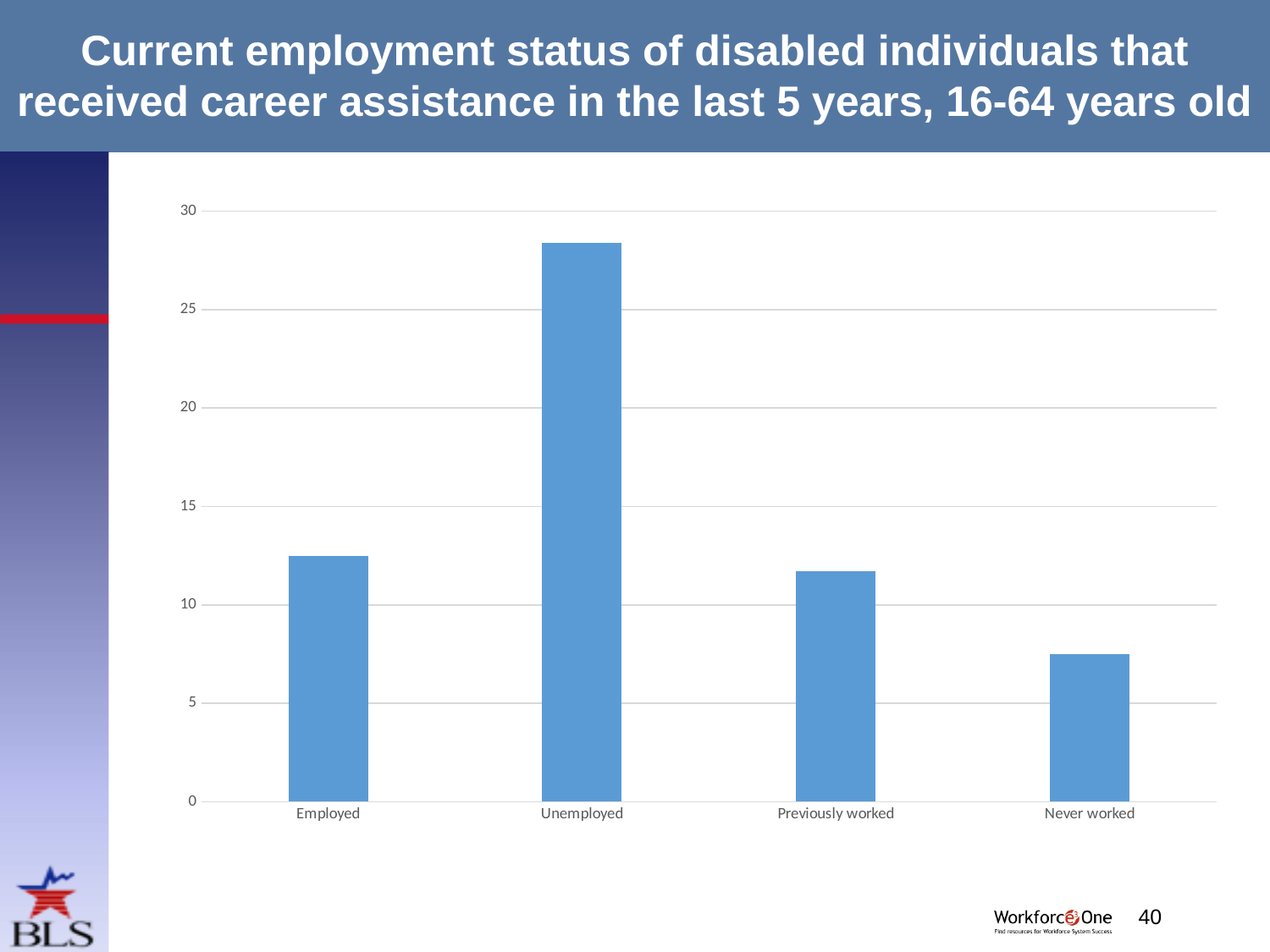
Is the value for Employed greater or less than 15? less Is the value for Unemployed greater or less than 25? greater Which category has the highest bar in the chart? Unemployed Which is larger, the value for Unemployed or the value for Previously worked? Unemployed How many categories are shown on the x axis of the chart? 4 Which category has the lowest bar in the chart? Never worked Is the value for Employed greater or less than 10? greater Which is larger, the value for Employed or the value for Never worked? Employed What is the title of the slide containing the chart? Current employment status of disabled individuals that received career assistance in the last 5 years, 16-64 years old What kind of chart is shown on the slide? bar chart